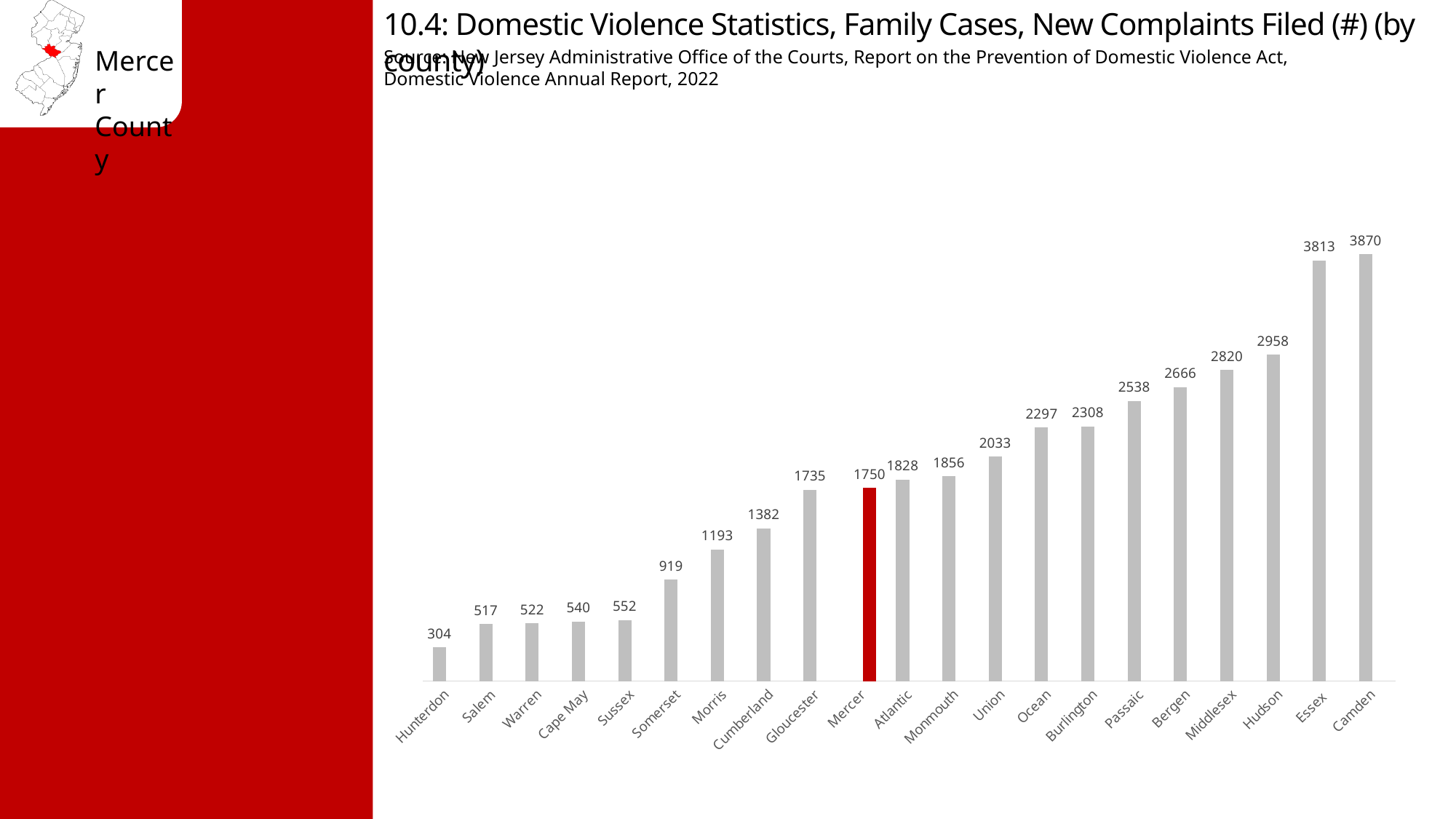
What is the value shown for Hunterdon? 304 How many counties are shown on the chart? 21 What is the difference between the values for Mercer and Hunterdon? 1446 What kind of chart is shown on the slide? Bar chart What is the difference between the values for Essex and Camden? 57 What is the value shown for Camden? 3870 Which county has the lowest number of new complaints filed? Hunterdon What is the number of new domestic violence complaints filed in Mercer County? 1750 Which has a larger value, Gloucester or Cumberland? Gloucester Which county has the highest number of new complaints filed? Camden Do the values rise or fall moving from left to right along the x axis? Rise Which county's bar is highlighted in red? Mercer